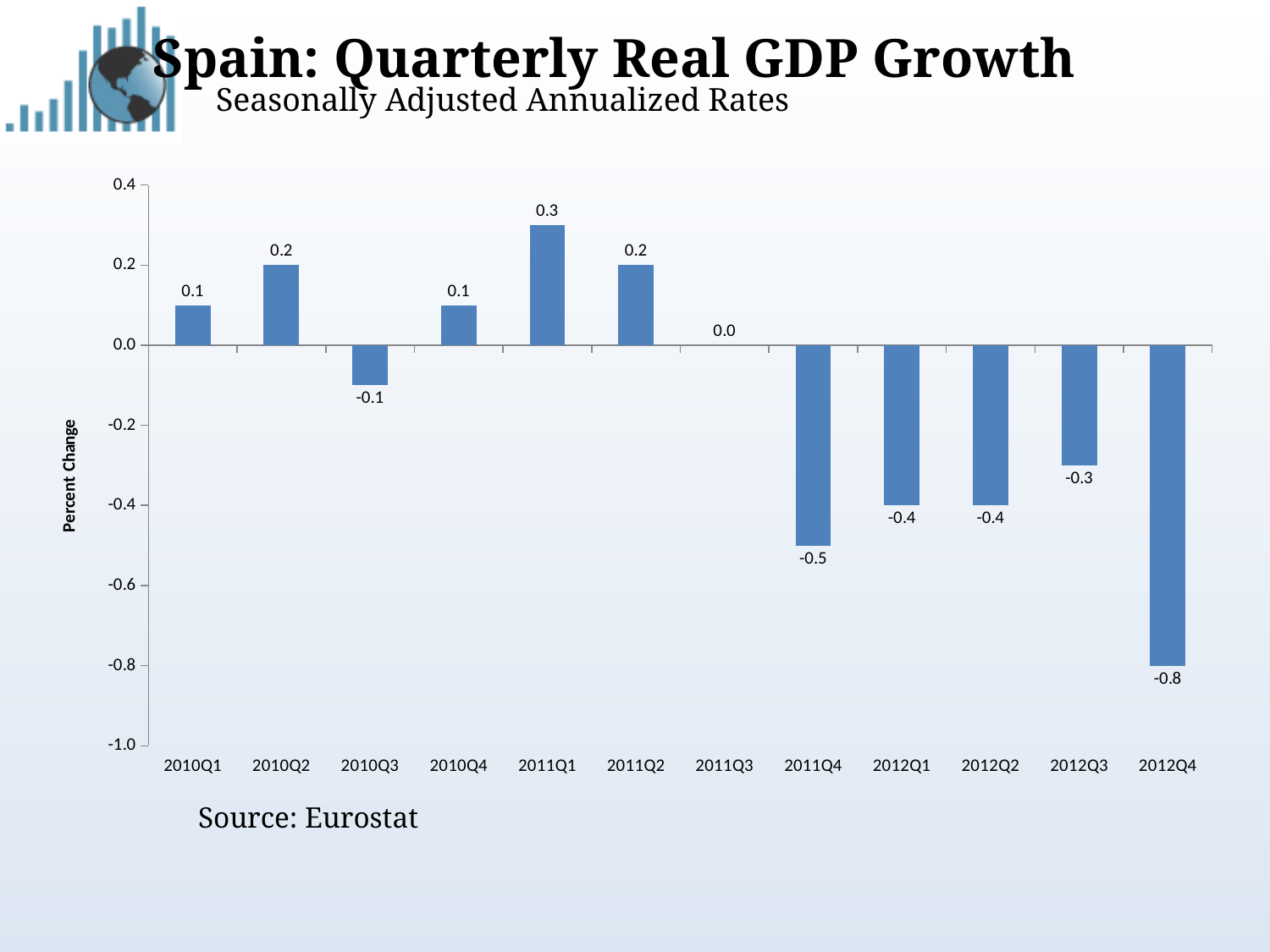
Which quarter has the highest value? 2011Q1 Which quarter has the lowest value? 2012Q4 Which is larger, the value for 2010Q2 or the value for 2011Q4? 2010Q2 What is the value for 2012Q4? -0.8 What is the value for 2011Q1? 0.3 What is the value for 2011Q3? 0.0 How many quarters are shown on the x axis? 12 What is the difference between the values for 2011Q1 and 2012Q4? 1.1 What kind of chart is this? Bar chart Do the values generally rise or fall from 2011Q2 to 2012Q4? Fall What is the value for 2010Q3? -0.1 What is the label of the y axis? Percent Change